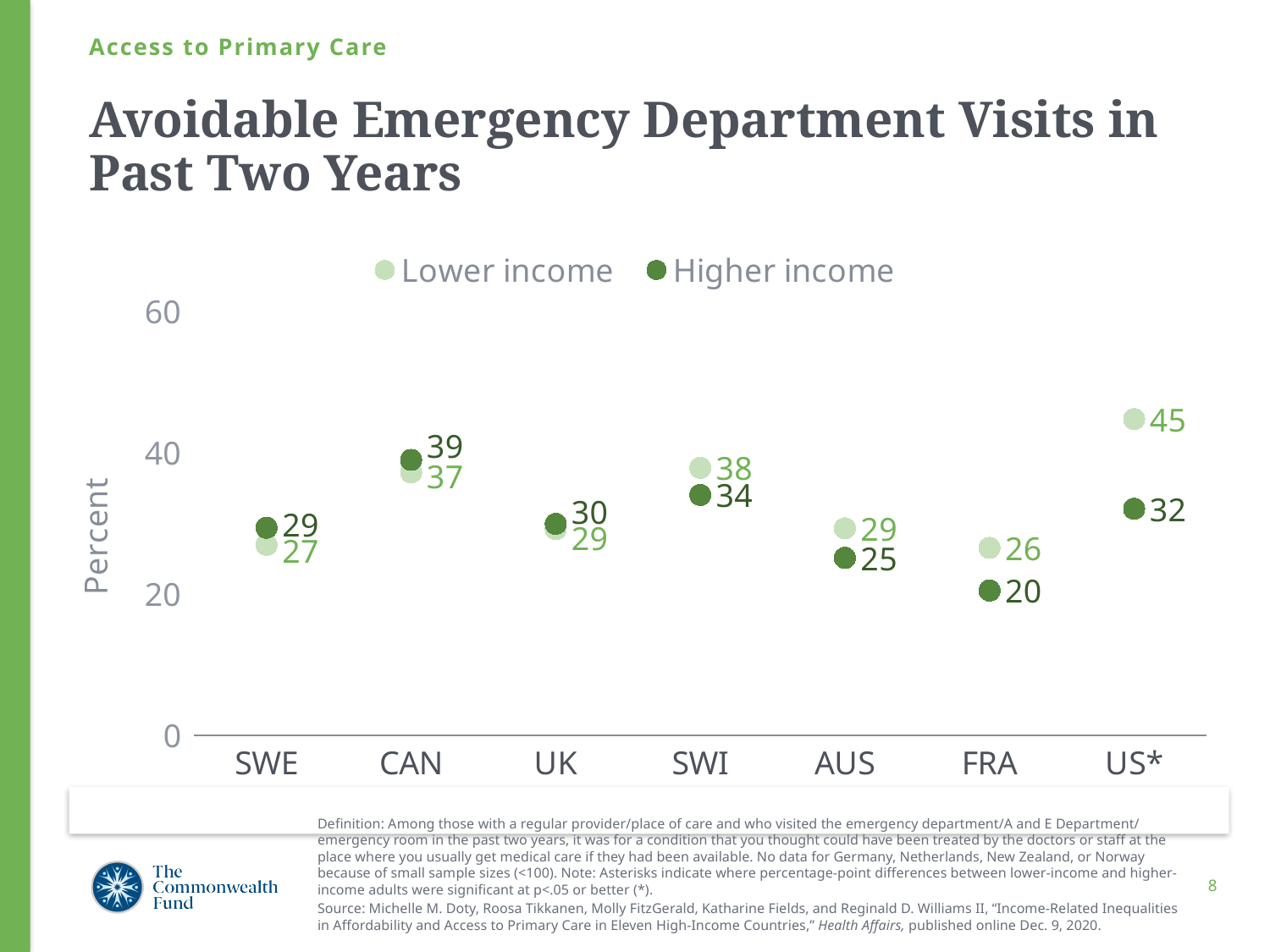
What is the Lower income value for US*? 45 What is the Higher income value for FRA? 20 What is the Higher income value for SWI? 34 Which country has the highest Higher income value? CAN How many series does the legend list? 2 What is the difference between the Lower income and Higher income values for US*? 13 For CAN, which is larger: the Lower income value or the Higher income value? Higher income What is the label on the y axis? Percent How many countries are shown on the x axis? 7 What is the difference between the Lower income and Higher income values for FRA? 6 Which country has the highest Lower income value? US* Which country has the lowest Higher income value? FRA